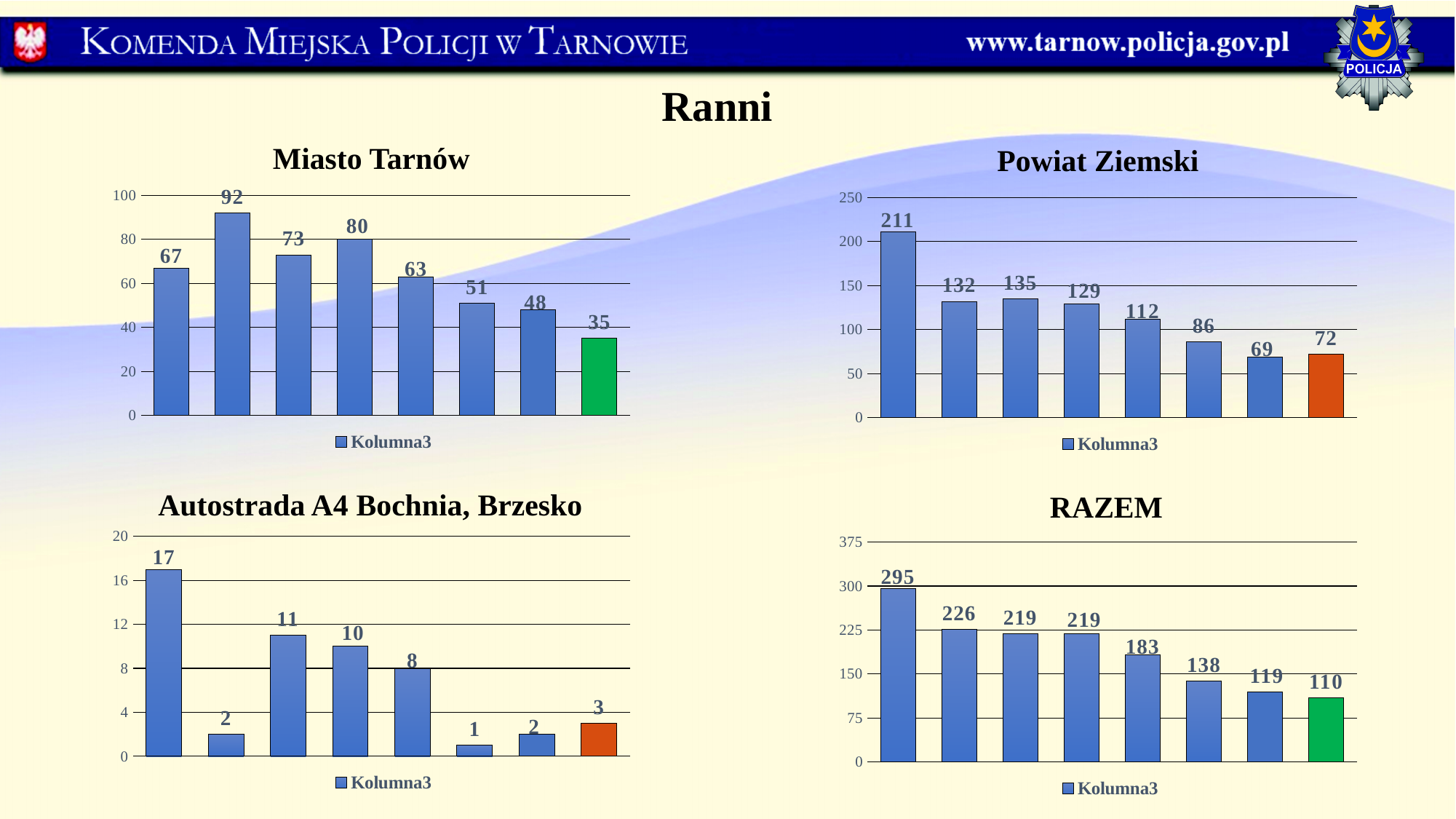
In the 'RAZEM' chart, is the value of the last (green) bar greater or less than 150? less In the 'Powiat Ziemski' chart, what is the lowest value shown? 69 In the 'Miasto Tarnów' chart, what is the value of the last (green) bar? 35 In the 'RAZEM' chart, which is larger: the first bar or the last bar? the first bar (295) What type of chart is the 'RAZEM' chart? bar chart In the 'RAZEM' chart, what is the value of the first bar? 295 In the 'Autostrada A4 Bochnia, Brzesko' chart, what is the lowest value shown? 1 In the 'Autostrada A4 Bochnia, Brzesko' chart, what is the highest value shown? 17 In the 'Miasto Tarnów' chart, what is the highest value shown? 92 In the 'Miasto Tarnów' chart, how many bars are plotted? 8 In the 'Powiat Ziemski' chart, what is the difference between the first bar (211) and the last bar (72)? 139 In the 'Powiat Ziemski' chart, what is the value of the first bar? 211